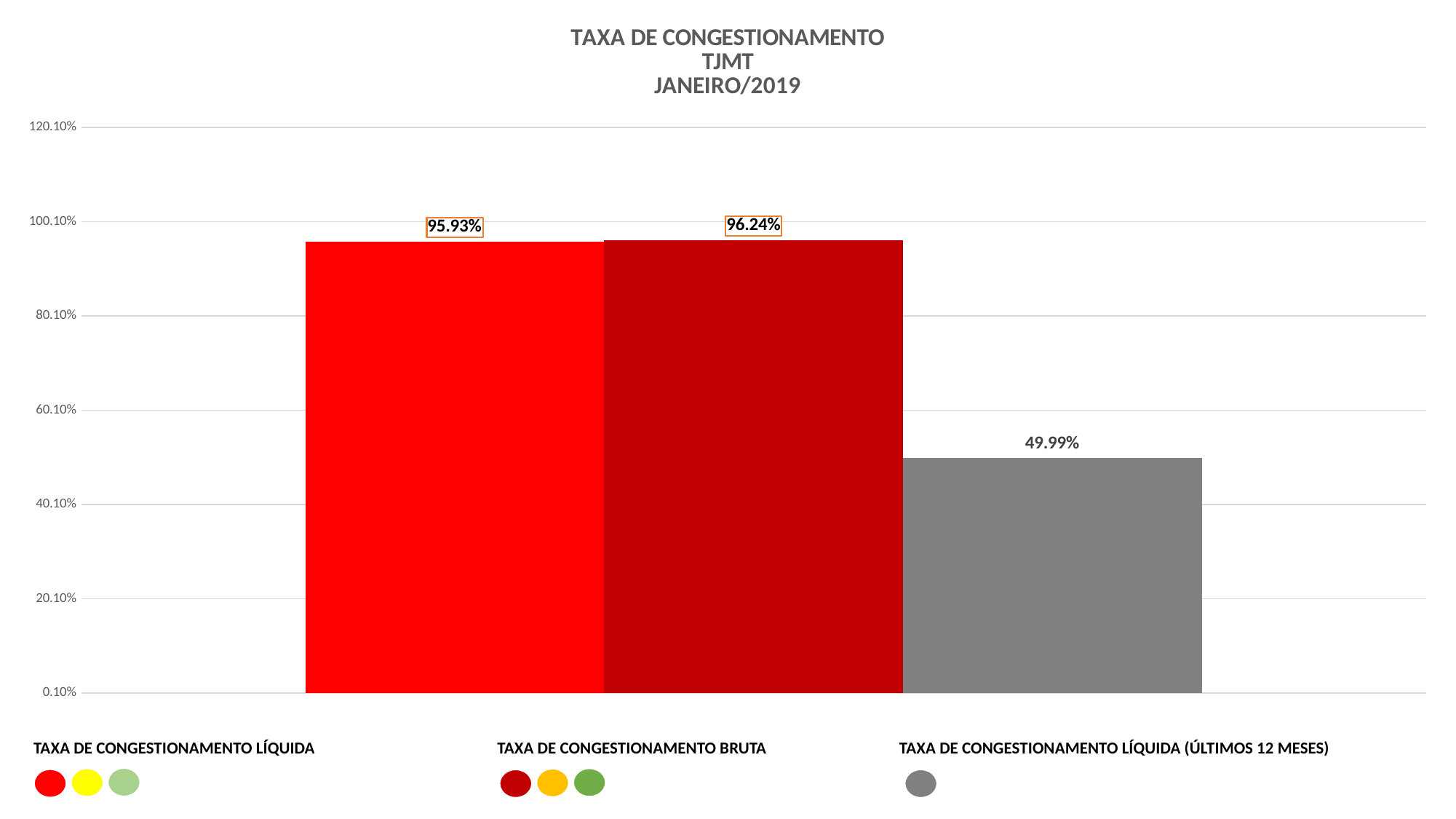
What is the title of the chart? TAXA DE CONGESTIONAMENTO TJMT JANEIRO/2019 What is the difference between Taxa de Congestionamento Bruta and Taxa de Congestionamento Líquida? 0.31% Which is larger, Taxa de Congestionamento Líquida or Taxa de Congestionamento Líquida (Últimos 12 Meses)? Taxa de Congestionamento Líquida What is the difference between Taxa de Congestionamento Líquida and Taxa de Congestionamento Líquida (Últimos 12 Meses)? 45.94% What is the value for Taxa de Congestionamento Líquida (Últimos 12 Meses)? 49.99% Which series has the highest value? Taxa de Congestionamento Bruta What is the value for Taxa de Congestionamento Bruta? 96.24% Which series has the lowest value? Taxa de Congestionamento Líquida (Últimos 12 Meses) What is the value for Taxa de Congestionamento Líquida? 95.93% How many bars are plotted on the chart? 3 Is the value for Taxa de Congestionamento Líquida (Últimos 12 Meses) greater or less than 60.10%? less What kind of chart is shown on the slide? bar chart